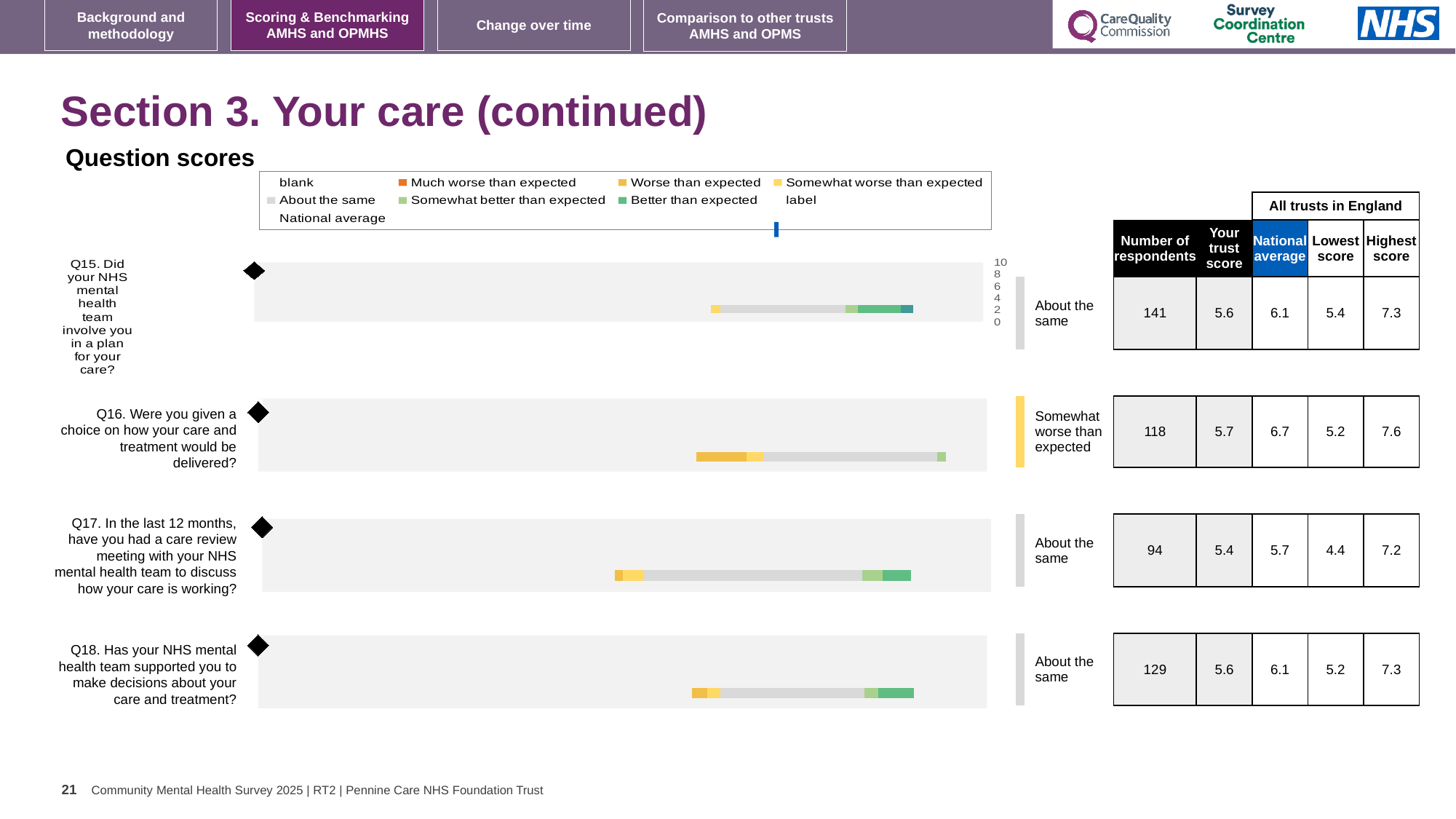
Which question has the highest number of respondents? Q15 Which question has the lowest trust score? Q17 What colour does the legend use for 'Better than expected'? Green How many questions (Q15 to Q18) are plotted on the slide? 4 What kind of chart is used to show the question scores for Q15 to Q18? Bar chart What rating label is shown next to the bar for Q16? Somewhat worse than expected Which has the larger lowest score across all trusts in England, Q15 or Q18? Q15 What is the number of respondents for Q16? 118 For Q16, what is the difference between the national average and the trust score? 1.0 What is the highest score across all trusts in England for Q18? 7.3 What is the national average for Q15? 6.1 What is the trust score for Q17? 5.4